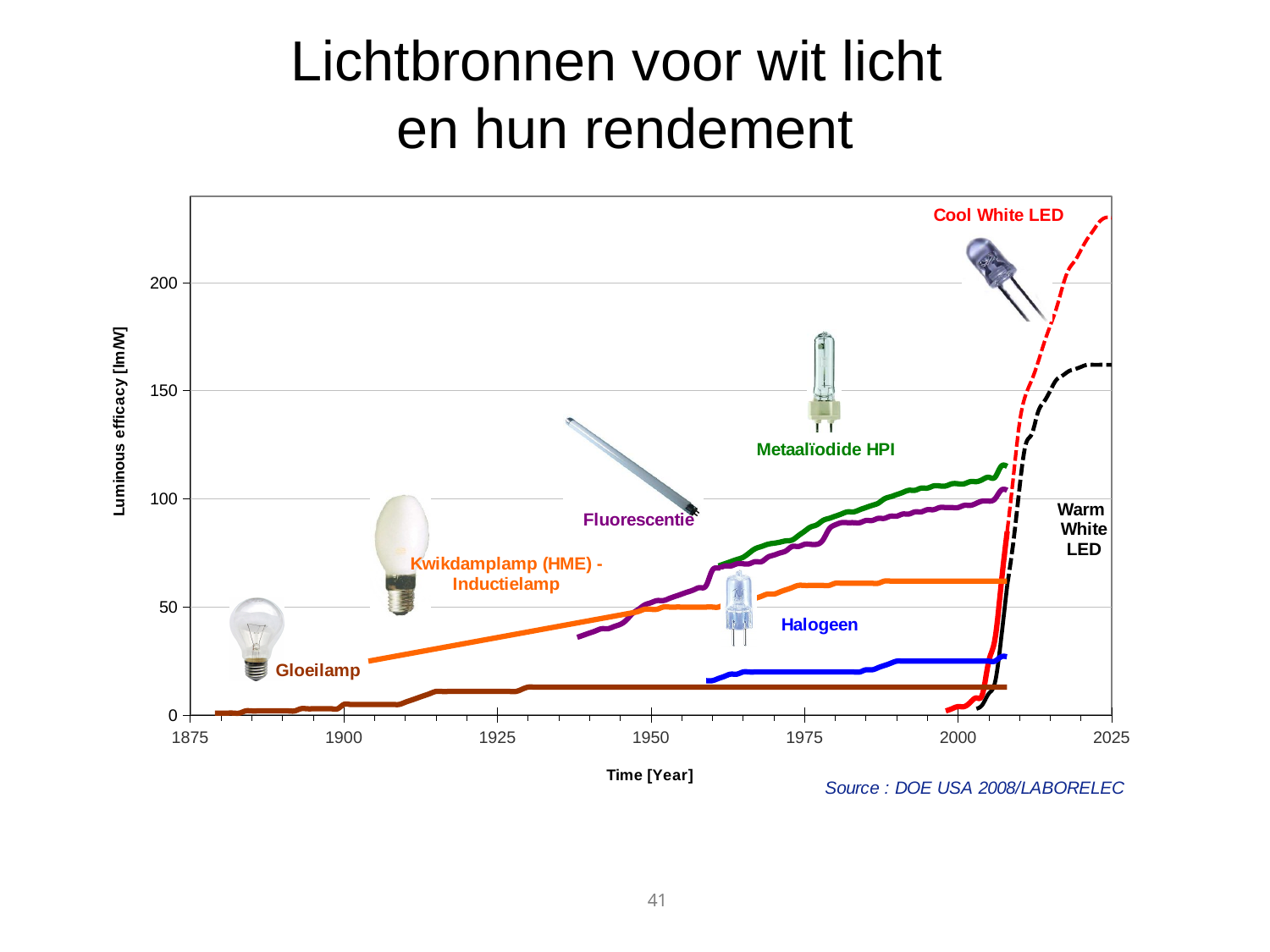
Does the luminous efficacy of Kwikdamplamp (HME) - Inductielamp rise or fall over time? rise Which light source reaches the highest luminous efficacy by 2025? Cool White LED What kind of chart is shown on the slide? line chart Is the luminous efficacy of Warm White LED in 2025 greater or less than 150 lm/W? greater What is the label of the vertical axis? Luminous efficacy [lm/W] In 2000, which has the higher luminous efficacy: Metaalïodide HPI or Halogeen? Metaalïodide HPI Is the luminous efficacy of Gloeilamp in 2000 greater or less than 50 lm/W? less Is the luminous efficacy of Halogeen in 2000 greater or less than 50 lm/W? less How many light-source series are labelled on the chart? 7 Which light source has the lowest luminous efficacy in 2000? Cool White LED